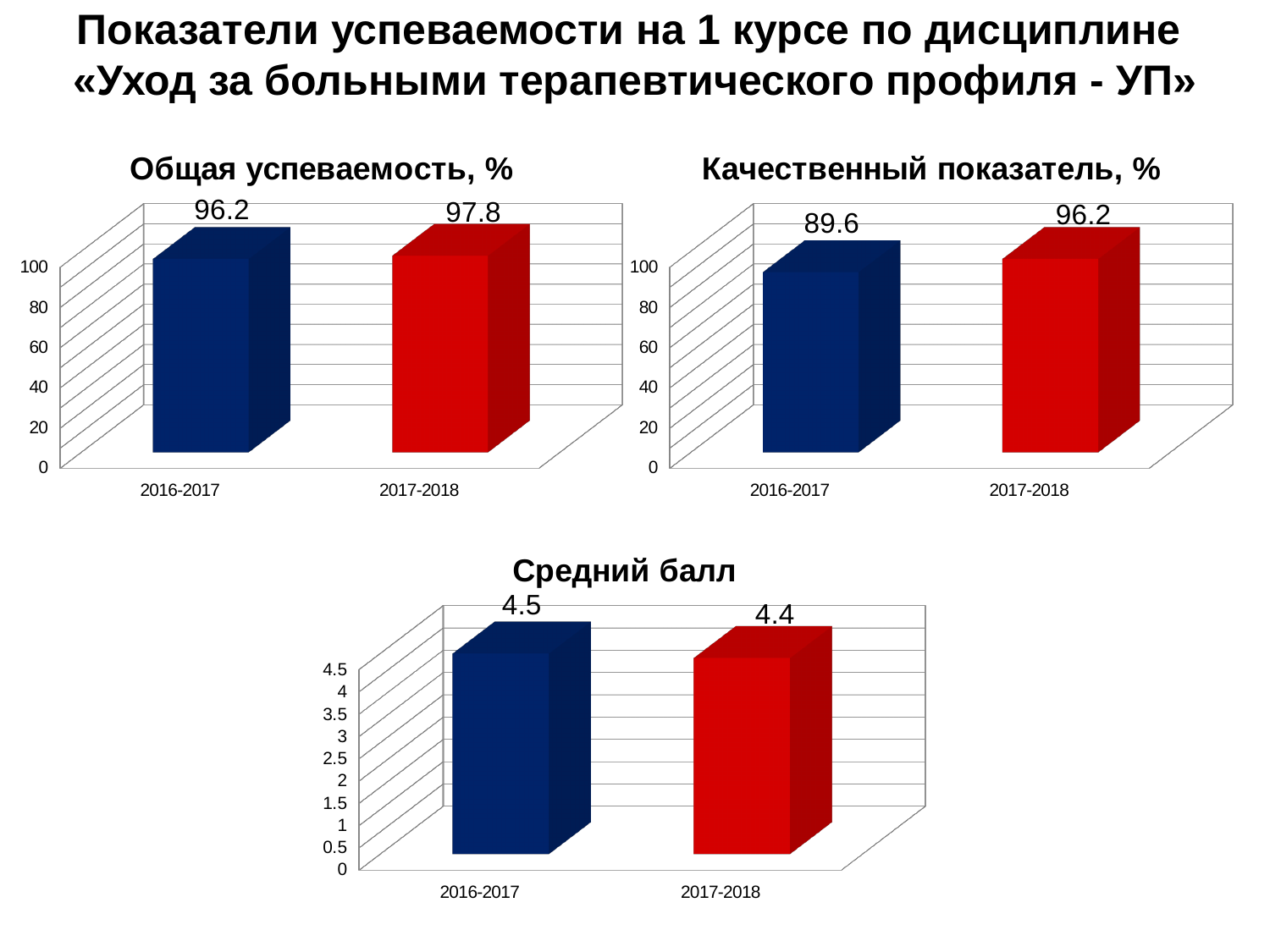
In the chart titled «Общая успеваемость, %», what is the value for 2016-2017? 96.2 In the chart titled «Качественный показатель, %», which year has the higher value? 2017-2018 In the chart titled «Качественный показатель, %», what is the difference between the 2017-2018 and 2016-2017 values? 6.6 In the chart titled «Качественный показатель, %», what is the value for 2017-2018? 96.2 In the chart titled «Средний балл», do the values rise or fall from 2016-2017 to 2017-2018? fall In the chart titled «Общая успеваемость, %», what is the value for 2017-2018? 97.8 How many categories are shown on the x axis of the chart titled «Общая успеваемость, %»? 2 In the chart titled «Средний балл», what is the value for 2017-2018? 4.4 In the chart titled «Качественный показатель, %», what is the value for 2016-2017? 89.6 In the chart titled «Общая успеваемость, %», what is the difference between the 2017-2018 and 2016-2017 values? 1.6 In the chart titled «Средний балл», what is the value for 2016-2017? 4.5 In the chart titled «Средний балл», which year has the lower value? 2017-2018